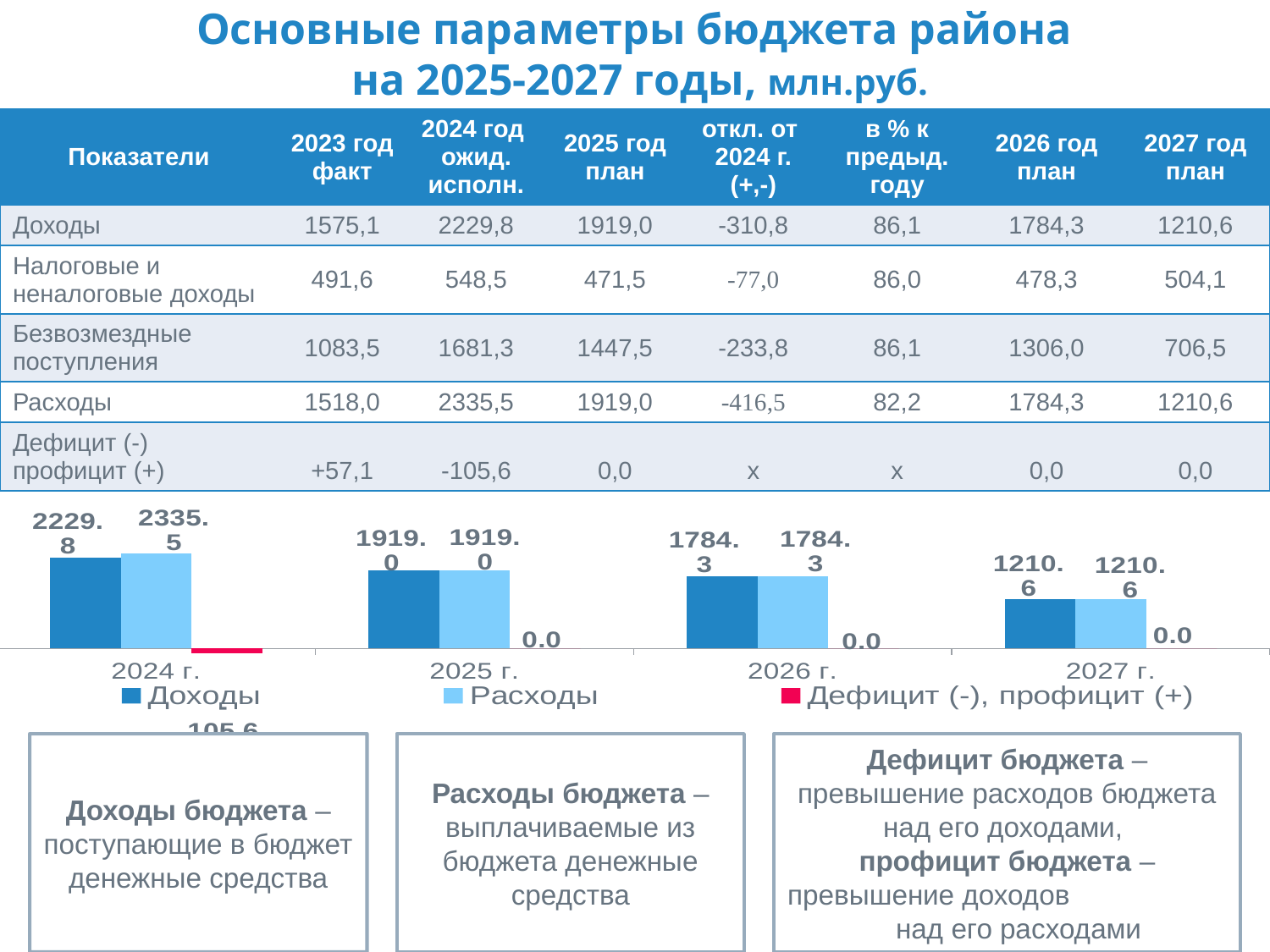
How many year categories are shown on the x axis of the chart? 4 How many series does the chart legend list? 3 What kind of chart is shown below the table on the slide? bar chart In the chart, do the Доходы values rise or fall from 2024 г. to 2027 г.? fall In the chart, what is the value of Дефицит (-), профицит (+) for 2026 г.? 0.0 In the chart, what is the value of Доходы for 2026 г.? 1784.3 In the chart, which year has the lowest value for Расходы? 2027 г. In the chart, what is the difference between Расходы and Доходы for 2024 г.? 105.7 In the chart, what is the value of Доходы for 2027 г.? 1210.6 In the chart, what is the value of Расходы for 2025 г.? 1919.0 In the chart, what is the value of Расходы for 2024 г.? 2335.5 In the chart, what is the value of Доходы for 2024 г.? 2229.8